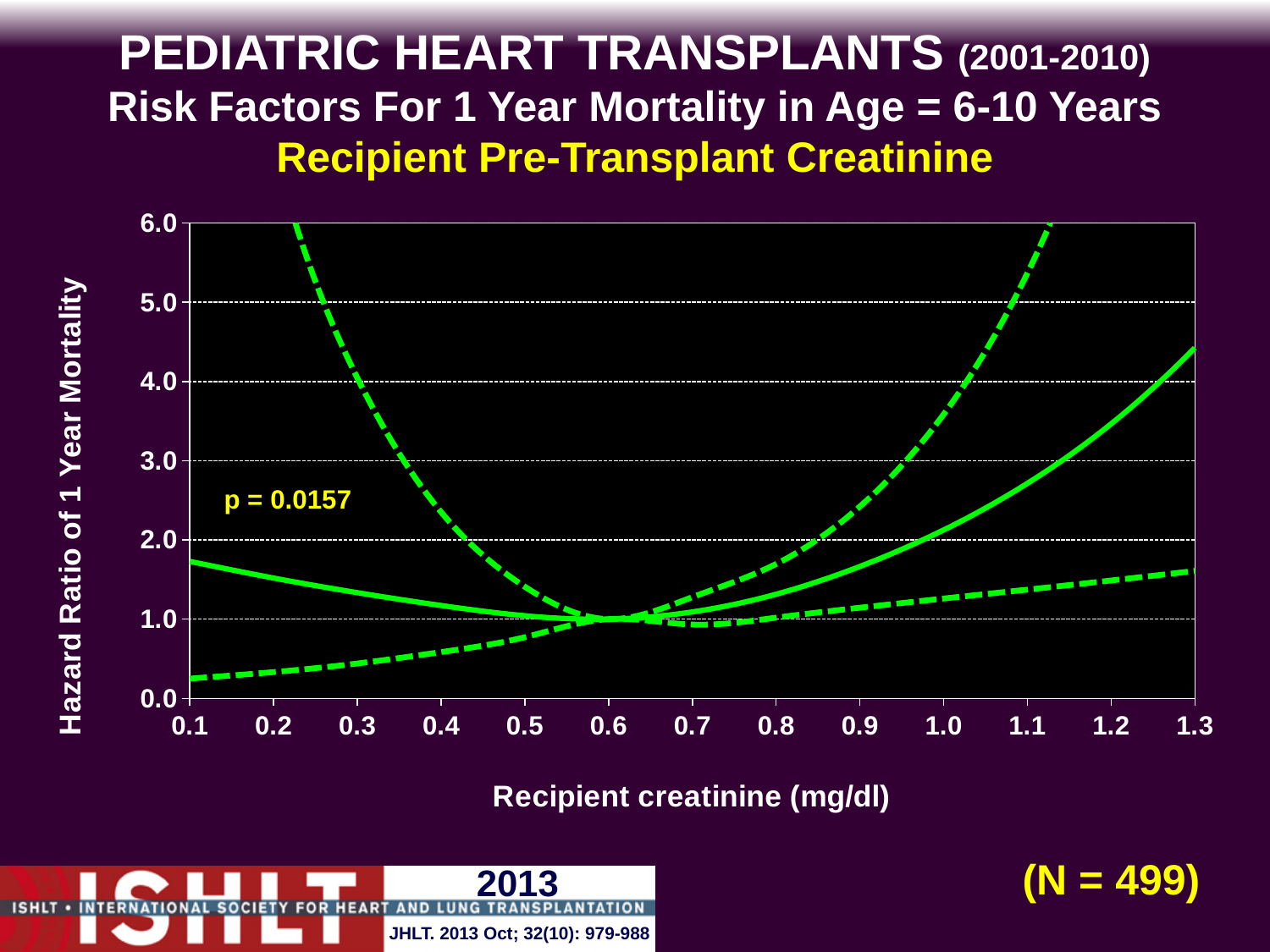
What kind of chart is shown on the slide? line chart Is the value of the upper dashed line at a recipient creatinine of 1.1 mg/dl greater or less than 5.0? greater What is the title of the chart's y axis? Hazard Ratio of 1 Year Mortality What is the highest value labelled on the y axis? 6.0 How many tick marks are labelled on the x axis? 13 Is the value of the lower dashed line at a recipient creatinine of 1.3 mg/dl greater or less than 2.0? less What is the title of the chart's x axis? Recipient creatinine (mg/dl) Does the solid line rise or fall as recipient creatinine increases from 0.1 to 0.5 mg/dl? fall Is the value of the solid line at a recipient creatinine of 0.1 mg/dl greater or less than 2.0? less Does the solid line rise or fall as recipient creatinine increases from 0.9 to 1.3 mg/dl? rise